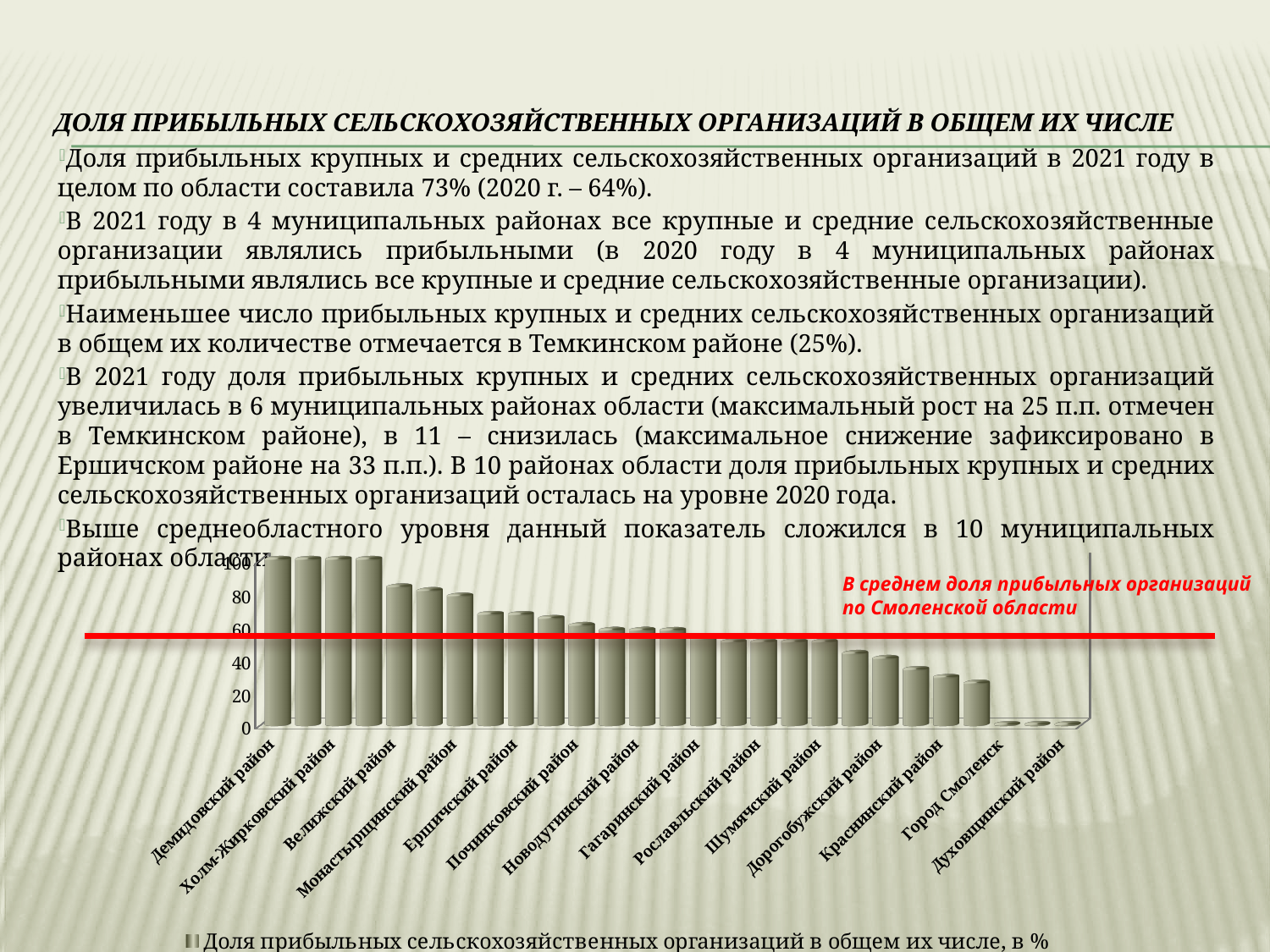
Do the bar values rise or fall from left to right along the x axis? fall Is the value for Демидовский район greater or less than 80? greater What kind of chart is shown on the slide? bar chart Which has the larger value, Демидовский район or Краснинский район? Демидовский район How many bars reach the 100 mark on the chart? 4 How many series does the chart legend list? 1 What is the legend entry of the chart? Доля прибыльных сельскохозяйственных организаций в общем их числе, в % Is the value for Краснинский район greater or less than 60? less What is the highest tick value shown on the vertical axis? 100 Is the value for Шумячский район greater or less than 60? less What does the red horizontal line on the chart represent? В среднем доля прибыльных организаций по Смоленской области